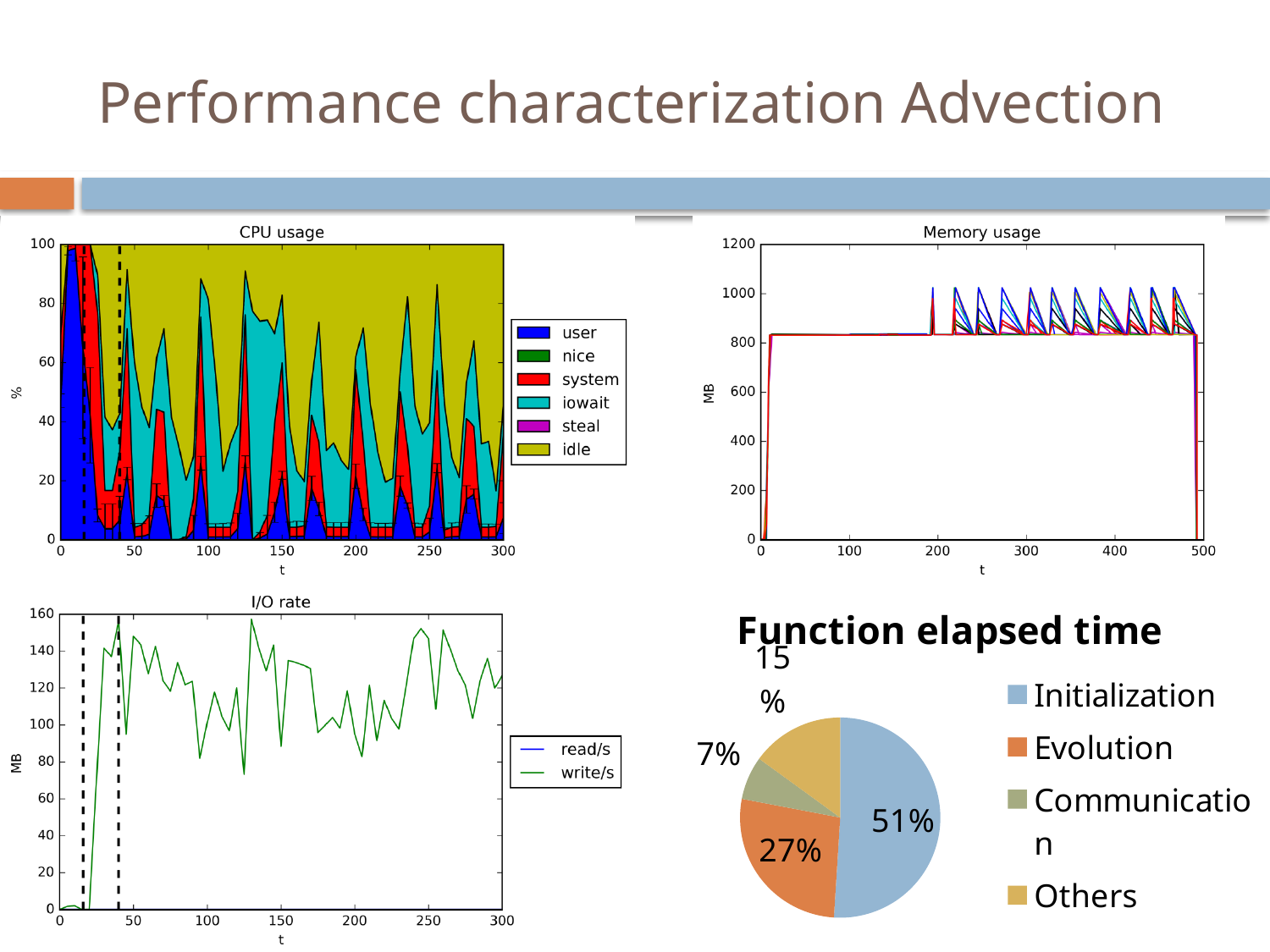
How many slices does the Function elapsed time pie chart have? 4 In the Function elapsed time pie chart, which function has the largest share? Initialization In the I/O rate chart, is the write/s value at t=100 greater or less than 60? greater In the Function elapsed time pie chart, how many percentage points larger is Initialization than Evolution? 24% In the Memory usage chart, is the value at t=100 greater or less than 600? greater In the Function elapsed time pie chart, which function has the smallest share? Communication In the Function elapsed time pie chart, what share does Others have? 15% In the Function elapsed time pie chart, what share does Evolution have? 27% In the Function elapsed time pie chart, what share does Initialization have? 51% How many series does the legend of the CPU usage chart list? 6 In the Function elapsed time pie chart, which is larger, Others or Communication? Others How many series does the legend of the I/O rate chart list? 2